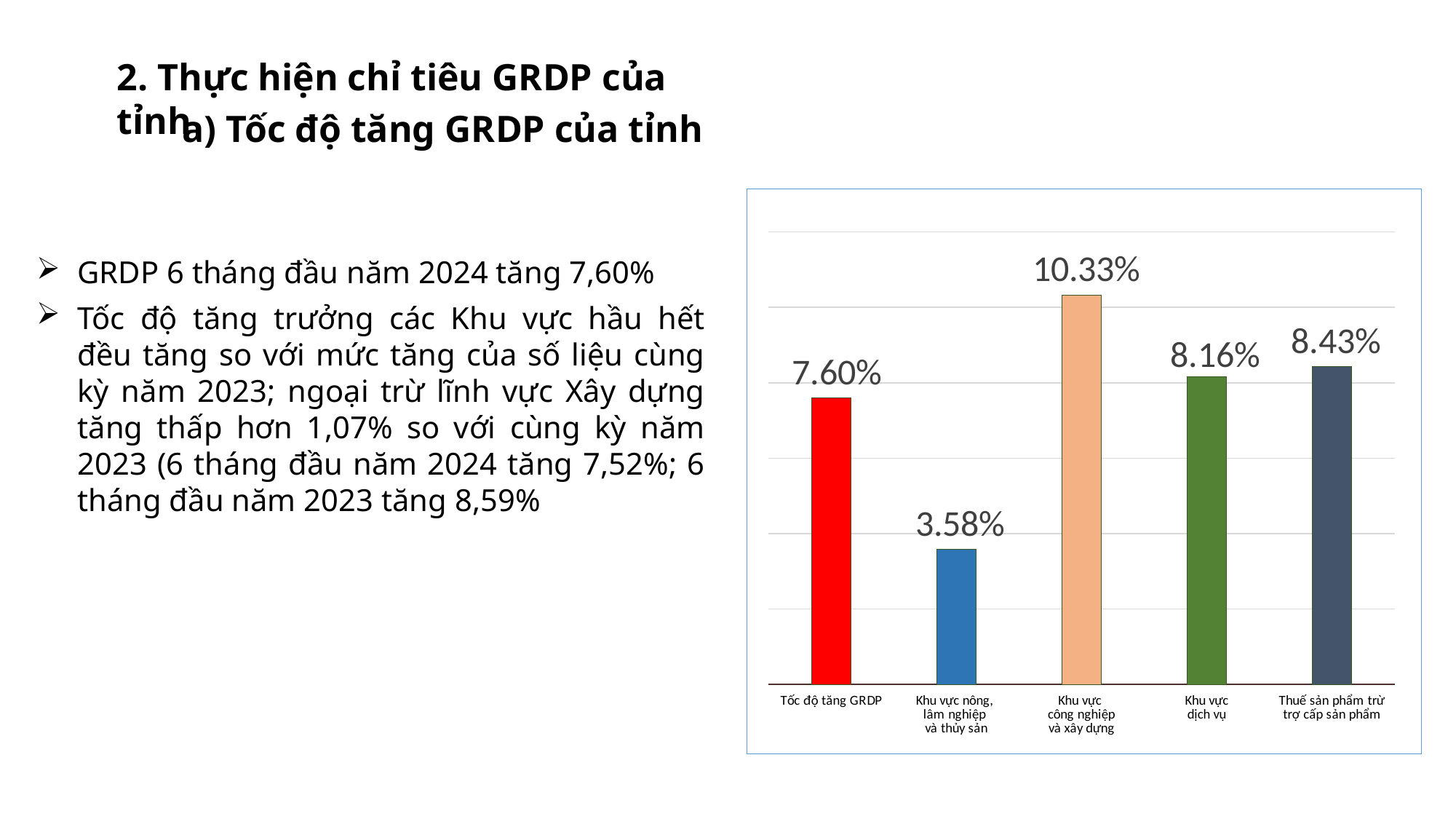
Which is larger, the value for Khu vực dịch vụ or the value for Thuế sản phẩm trừ trợ cấp sản phẩm? Thuế sản phẩm trừ trợ cấp sản phẩm How many categories are shown in the chart? 5 What is the value shown for Thuế sản phẩm trừ trợ cấp sản phẩm? 8.43% What kind of chart is shown on the slide? Bar chart What is the difference between the values for Thuế sản phẩm trừ trợ cấp sản phẩm and Khu vực dịch vụ? 0.27% Which category has the lowest value? Khu vực nông, lâm nghiệp và thủy sản What is the value shown for Tốc độ tăng GRDP? 7.60% What is the difference between the values for Khu vực công nghiệp và xây dựng and Khu vực nông, lâm nghiệp và thủy sản? 6.75% What colour is the bar for Tốc độ tăng GRDP? Red What is the value shown for Khu vực nông, lâm nghiệp và thủy sản? 3.58% Which category has the highest value? Khu vực công nghiệp và xây dựng What is the value shown for Khu vực công nghiệp và xây dựng? 10.33%